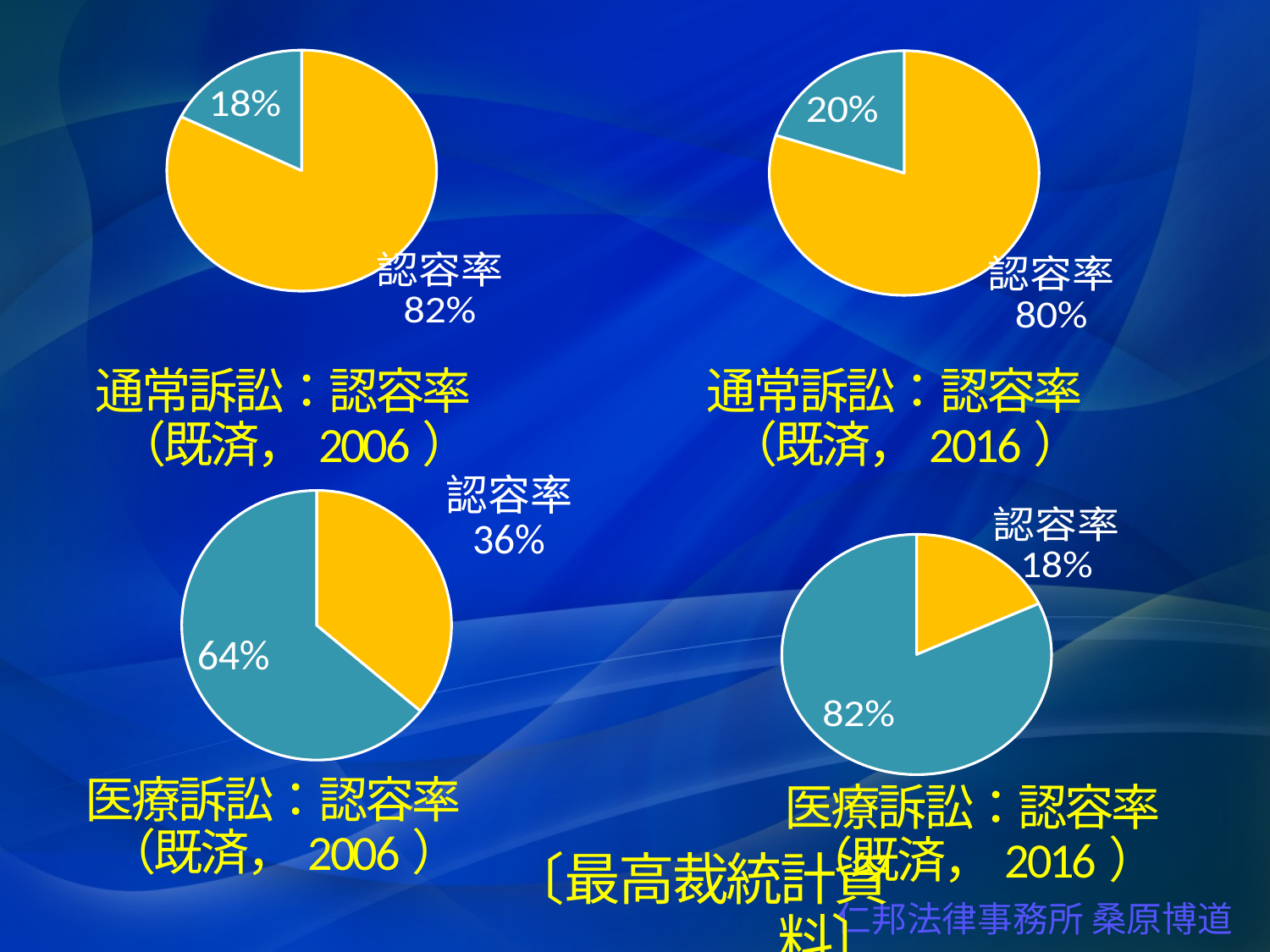
How many pie charts are shown on the slide? 4 In the top-left pie chart (通常訴訟：認容率（既済，2006）), what share does the teal slice represent? 18% In the bottom-left pie chart (医療訴訟：認容率（既済，2006）), what share does the teal slice represent? 64% Which is larger: the 認容率 in the bottom-left chart (医療訴訟, 2006) or in the bottom-right chart (医療訴訟, 2016)? 医療訴訟 2006 (36%) In the bottom-right pie chart (医療訴訟：認容率（既済，2016）), what is the 認容率 value? 18% How many slices does the bottom-right pie chart (医療訴訟：認容率（既済，2016）) have? 2 In the bottom-left pie chart (医療訴訟：認容率（既済，2006）), what is the 認容率 value? 36% Which of the four pie charts has the lowest 認容率? 医療訴訟：認容率（既済，2016） What is the difference between the 認容率 in the top-left chart (通常訴訟, 2006) and the bottom-left chart (医療訴訟, 2006)? 46% In the top-right pie chart (通常訴訟：認容率（既済，2016）), what is the 認容率 value? 80% What kind of chart is used for 通常訴訟：認容率（既済，2016）? Pie chart In the top-left pie chart (通常訴訟：認容率（既済，2006）), what is the 認容率 value? 82%